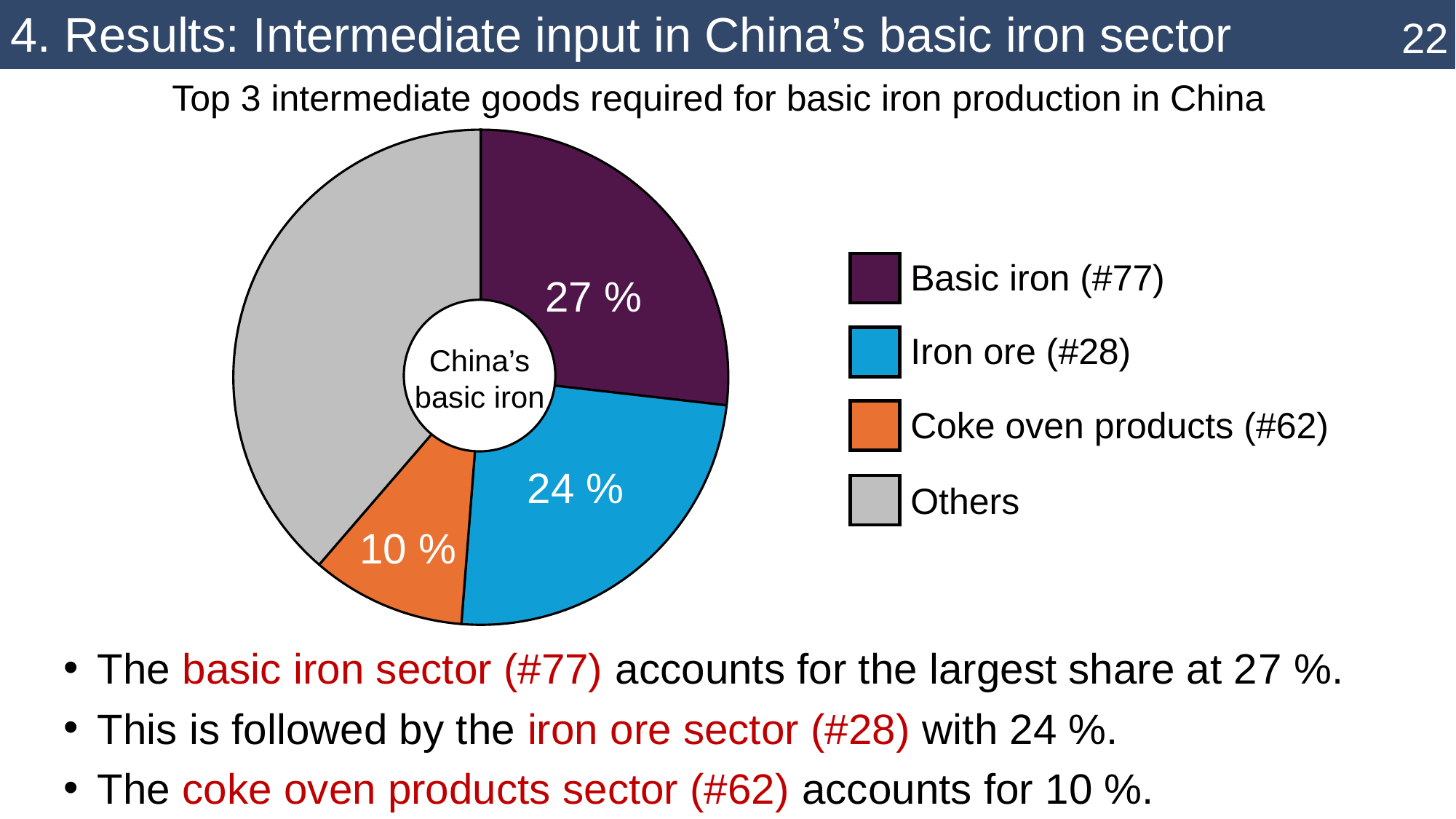
What share of the pie does Iron ore (#28) account for? 24 % What share of the pie does Coke oven products (#62) account for? 10 % What is the combined share of the three named intermediate goods (Basic iron, Iron ore and Coke oven products)? 61 % Which has a larger share, Iron ore (#28) or Coke oven products (#62)? Iron ore (#28) What is the title of the chart? Top 3 intermediate goods required for basic iron production in China What kind of chart is shown on the slide? Pie chart What is the difference in share between Basic iron (#77) and Iron ore (#28)? 3 % Among the three named intermediate goods, which has the smallest share? Coke oven products (#62) What share of the pie does Basic iron (#77) account for? 27 % How many slices does the pie chart have? 4 What is the difference in share between Iron ore (#28) and Coke oven products (#62)? 14 % Among the three named intermediate goods, which has the largest share? Basic iron (#77)